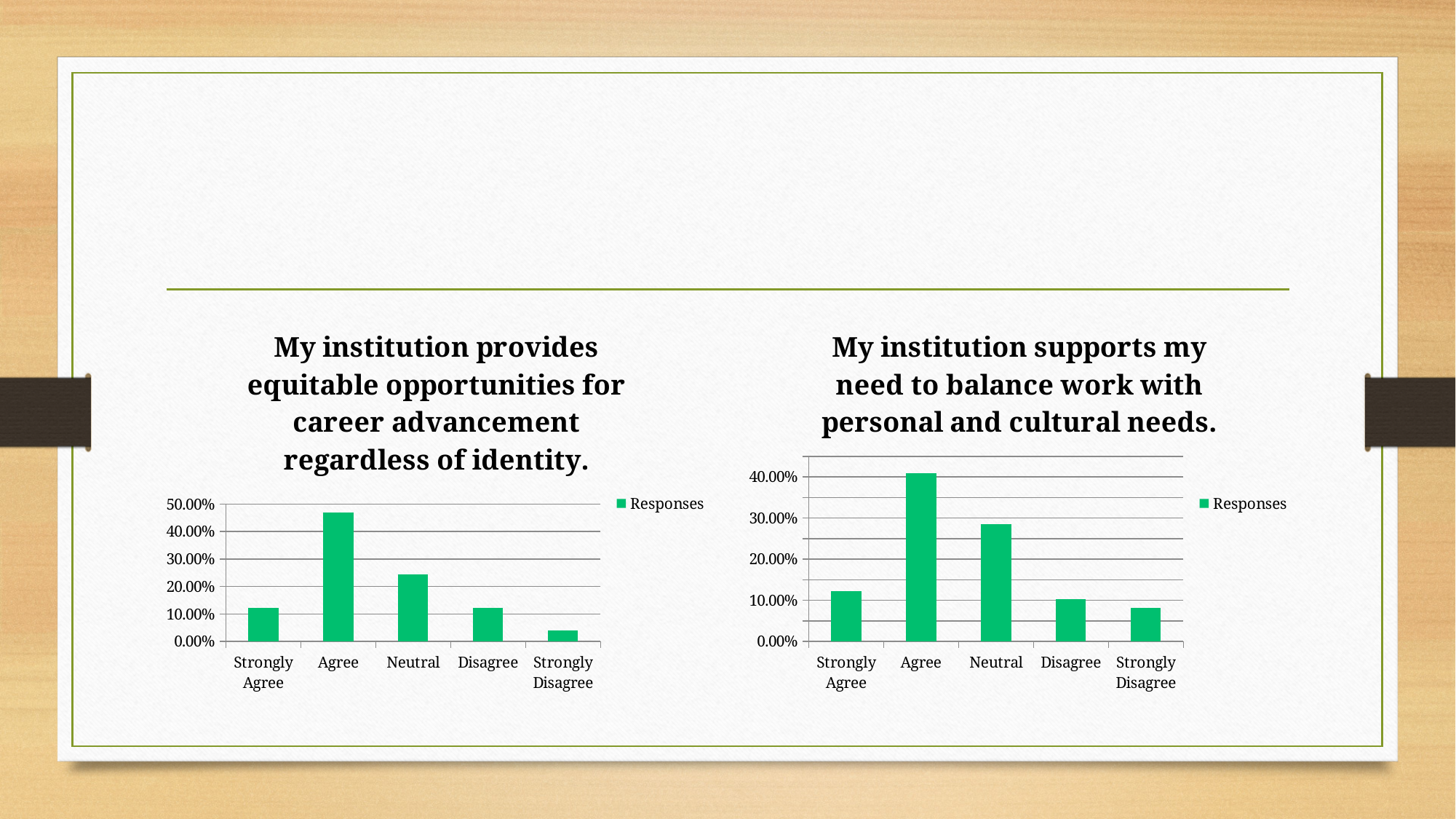
In the right chart titled "My institution supports my need to balance work with personal and cultural needs.", which response category has the lowest value? Strongly Disagree In the left chart titled "My institution provides equitable opportunities for career advancement regardless of identity.", which response category has the highest value? Agree In the left chart titled "My institution provides equitable opportunities for career advancement regardless of identity.", is the value for Neutral greater or less than 30.00%? less What kind of chart is the left chart titled "My institution provides equitable opportunities for career advancement regardless of identity."? Bar chart In the left chart titled "My institution provides equitable opportunities for career advancement regardless of identity.", which response category has the lowest value? Strongly Disagree In the right chart titled "My institution supports my need to balance work with personal and cultural needs.", which response category has the highest value? Agree In the right chart titled "My institution supports my need to balance work with personal and cultural needs.", is the value for Neutral greater or less than 20.00%? greater In the right chart titled "My institution supports my need to balance work with personal and cultural needs.", which is larger, the value for Neutral or the value for Disagree? Neutral How many series does the legend of the right chart titled "My institution supports my need to balance work with personal and cultural needs." list? 1 In the left chart titled "My institution provides equitable opportunities for career advancement regardless of identity.", is the value for Agree greater or less than 40.00%? greater In the left chart titled "My institution provides equitable opportunities for career advancement regardless of identity.", how many response categories are shown on the x axis? 5